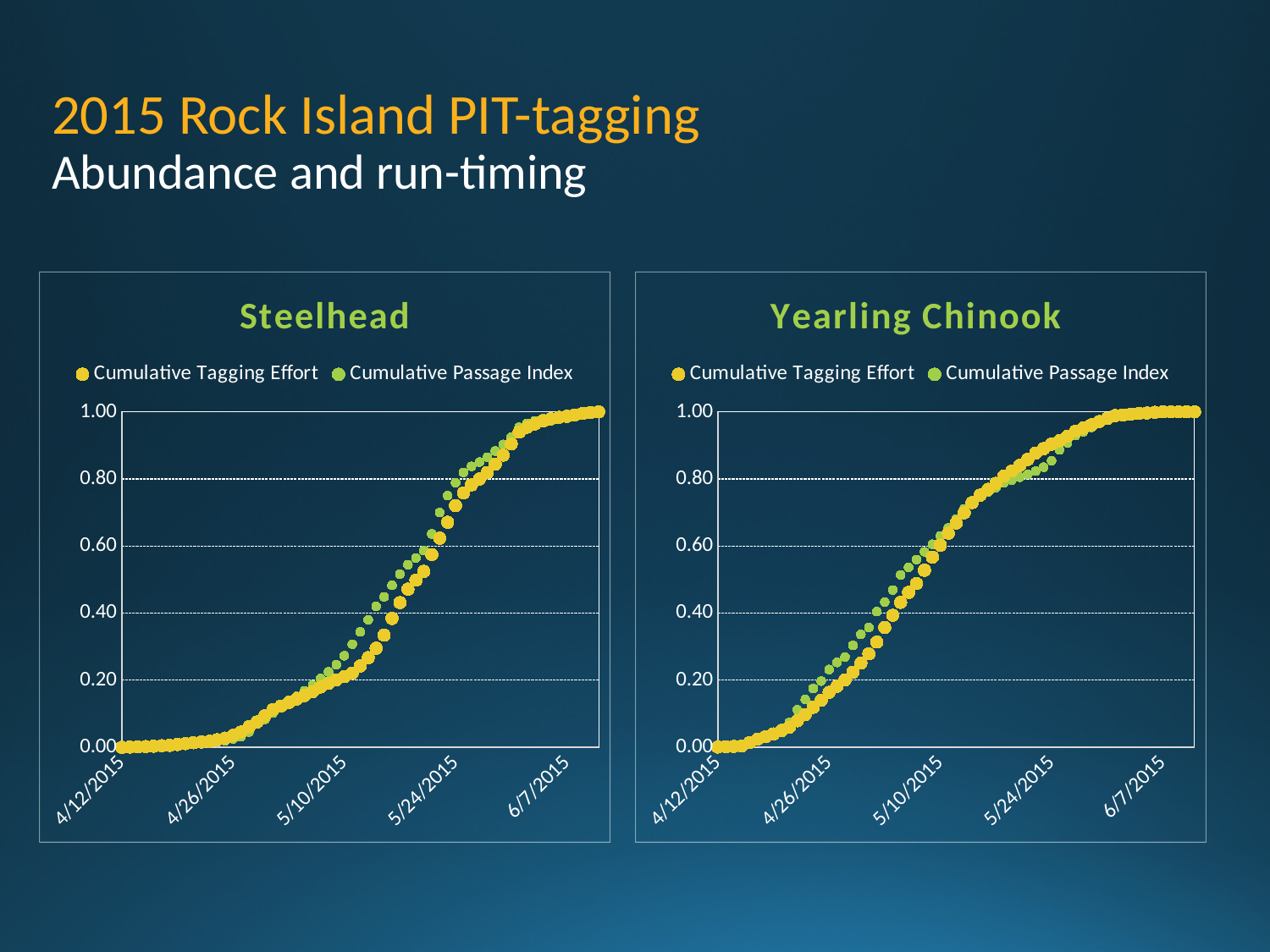
In the Yearling Chinook chart, is the Cumulative Tagging Effort value at 5/10/2015 greater or less than 0.40? greater In the Yearling Chinook chart, do the Cumulative Passage Index values rise or fall from 4/12/2015 to 6/7/2015? rise What is the title of the chart on the right side of the slide? Yearling Chinook In the Steelhead chart, which series is shown with green markers? Cumulative Passage Index How many series does the legend of the Yearling Chinook chart list? 2 In the Steelhead chart, is the Cumulative Tagging Effort value at 4/26/2015 greater or less than 0.20? less In the Steelhead chart, is the Cumulative Passage Index value at 6/7/2015 greater or less than 0.80? greater What kind of chart is the Steelhead chart? scatter chart In the Steelhead chart, do the Cumulative Tagging Effort values rise or fall along the x axis? rise